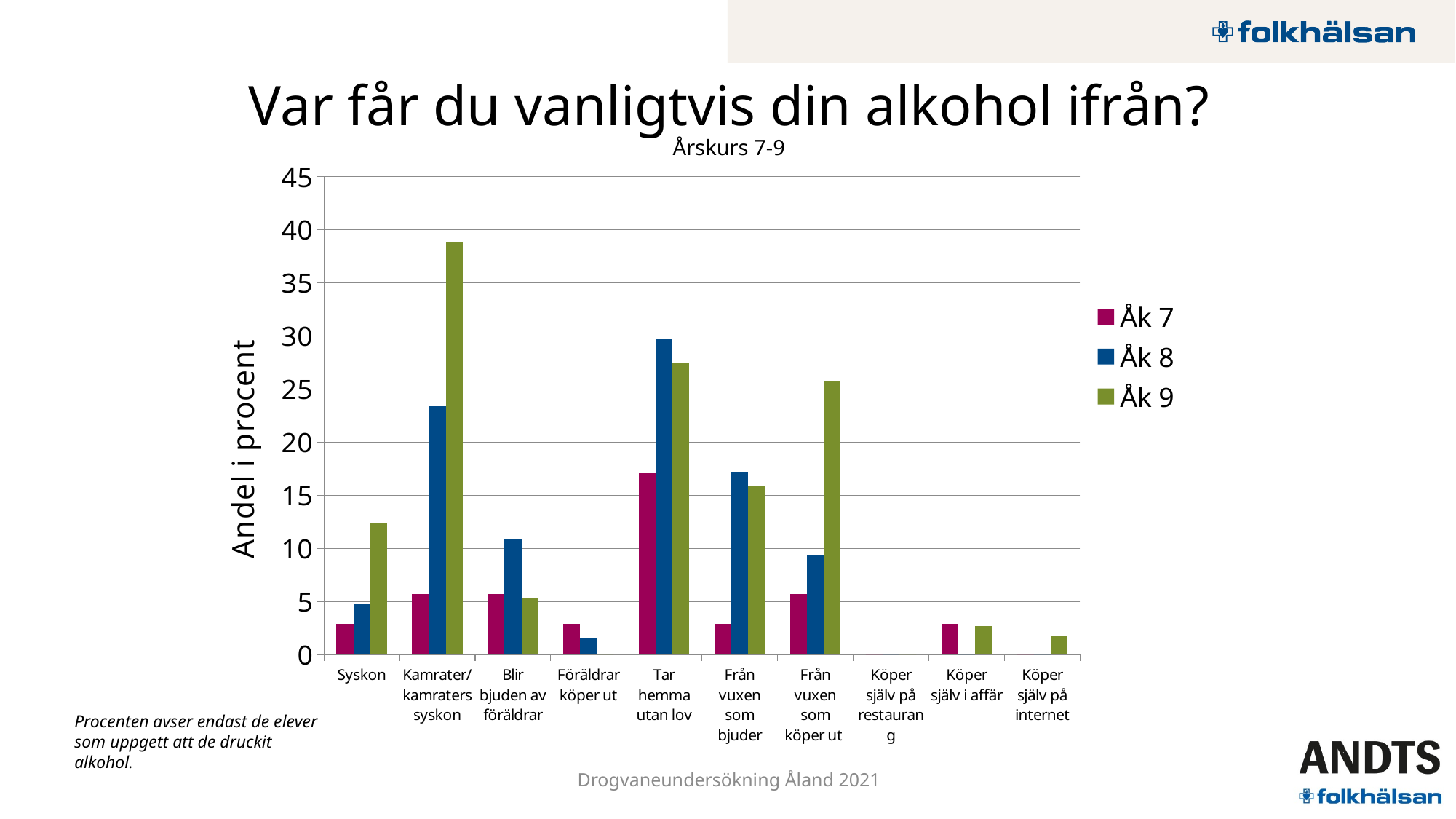
How many series does the legend list? 3 For Från vuxen som köper ut, which series has the larger value, Åk 8 or Åk 9? Åk 9 Is the Åk 9 value for Syskon greater or less than 10? greater What kind of chart is shown on the slide? bar chart Is the Åk 9 value for Från vuxen som köper ut greater or less than 20? greater Is the Åk 9 value for Kamrater/kamraters syskon greater or less than 35? greater For the Åk 7 series, which category has the highest value? Tar hemma utan lov For the Åk 9 series, which category has the highest value? Kamrater/kamraters syskon For the Åk 8 series, which category has the highest value? Tar hemma utan lov How many categories are shown on the x axis? 10 What is the title of the y axis? Andel i procent